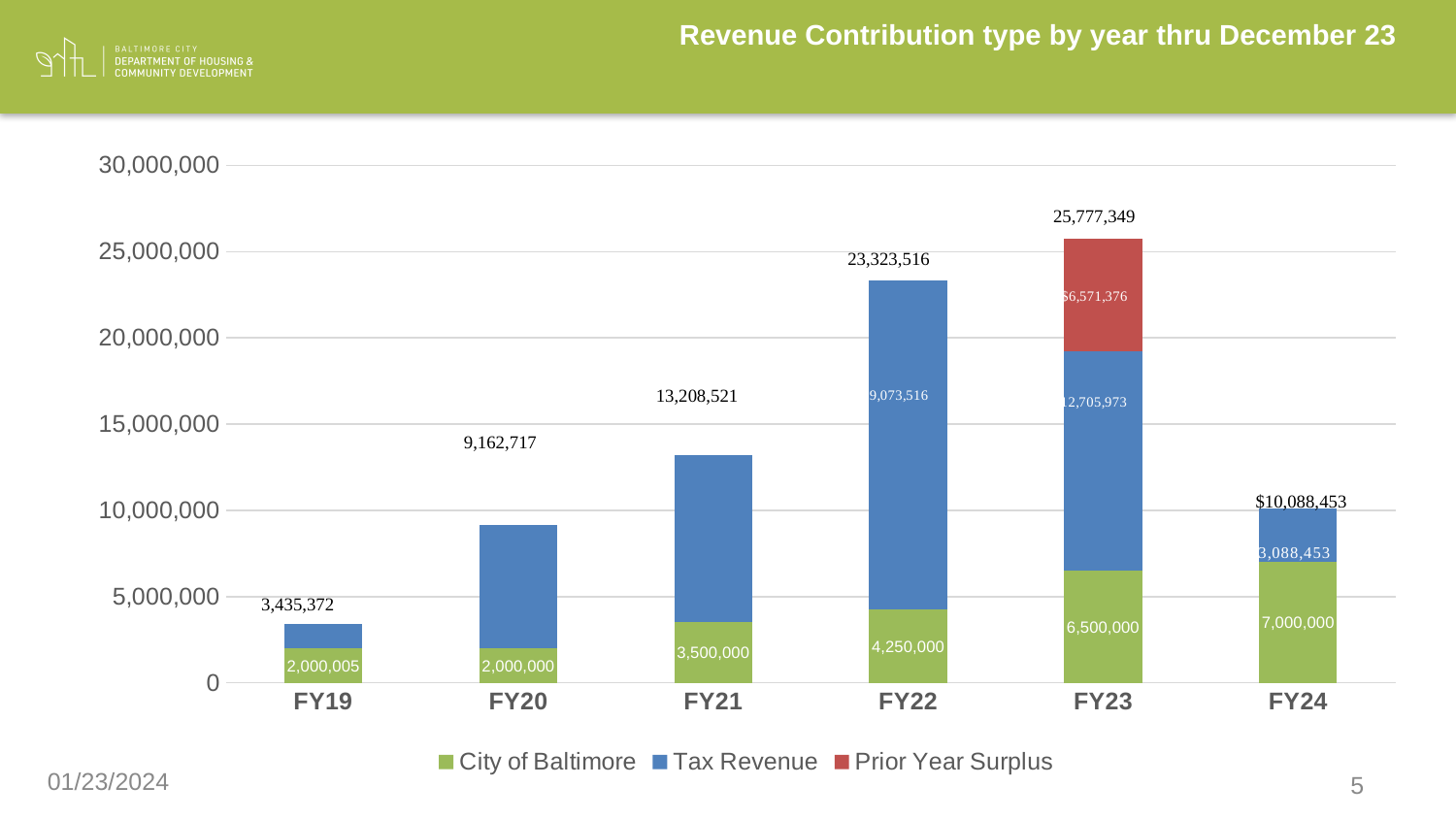
How much larger is the City of Baltimore contribution in FY24 than in FY23? 500,000 Do the total revenue contributions rise or fall from FY19 to FY23? rise What is the City of Baltimore contribution for FY21? 3,500,000 What kind of chart is shown on the slide? stacked bar chart Is the total for FY20 greater or less than 10,000,000? less Which has the larger total revenue contribution, FY21 or FY22? FY22 How many fiscal years are shown on the x axis? 6 Which fiscal year has the lowest total revenue contribution? FY19 Which fiscal year has the highest total revenue contribution? FY23 What is the total revenue contribution labeled above the FY22 bar? 23,323,516 What is the Tax Revenue value for FY24? 3,088,453 How many series does the legend list? 3